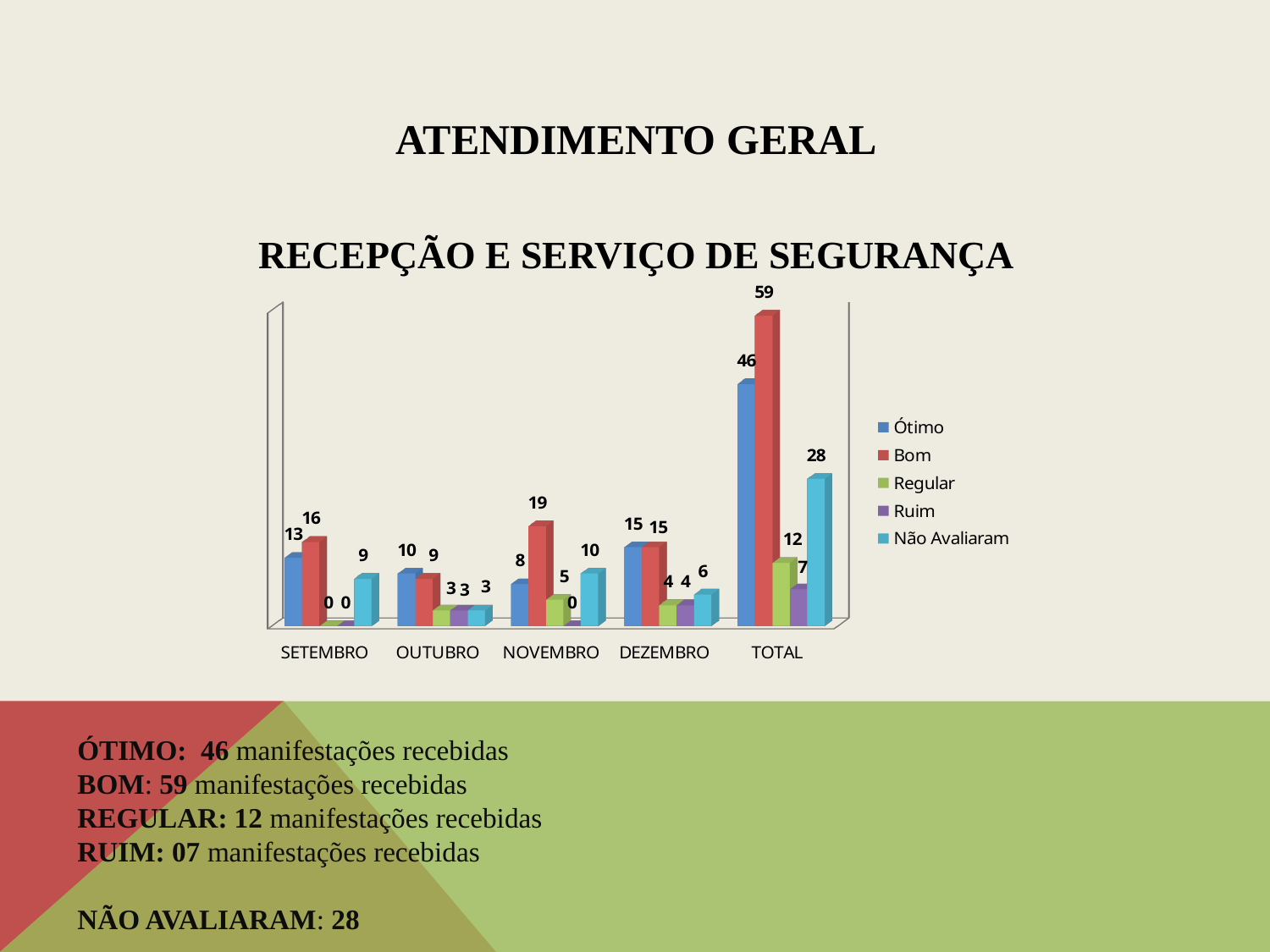
How many series does the legend list? 5 What kind of chart is shown on the slide? Bar chart How many categories are shown on the x axis? 5 What is the value for Bom in the TOTAL category? 59 What is the value for Não Avaliaram in NOVEMBRO? 10 What is the value for Regular in DEZEMBRO? 4 What is the difference between the Bom and Ótimo values in the TOTAL category? 13 Which series has the highest value in the TOTAL category? Bom What is the value for Ótimo in SETEMBRO? 13 What is the title of the chart? RECEPÇÃO E SERVIÇO DE SEGURANÇA Which series has the lowest value in the TOTAL category? Ruim Which is larger in NOVEMBRO, the value for Bom or the value for Ótimo? Bom